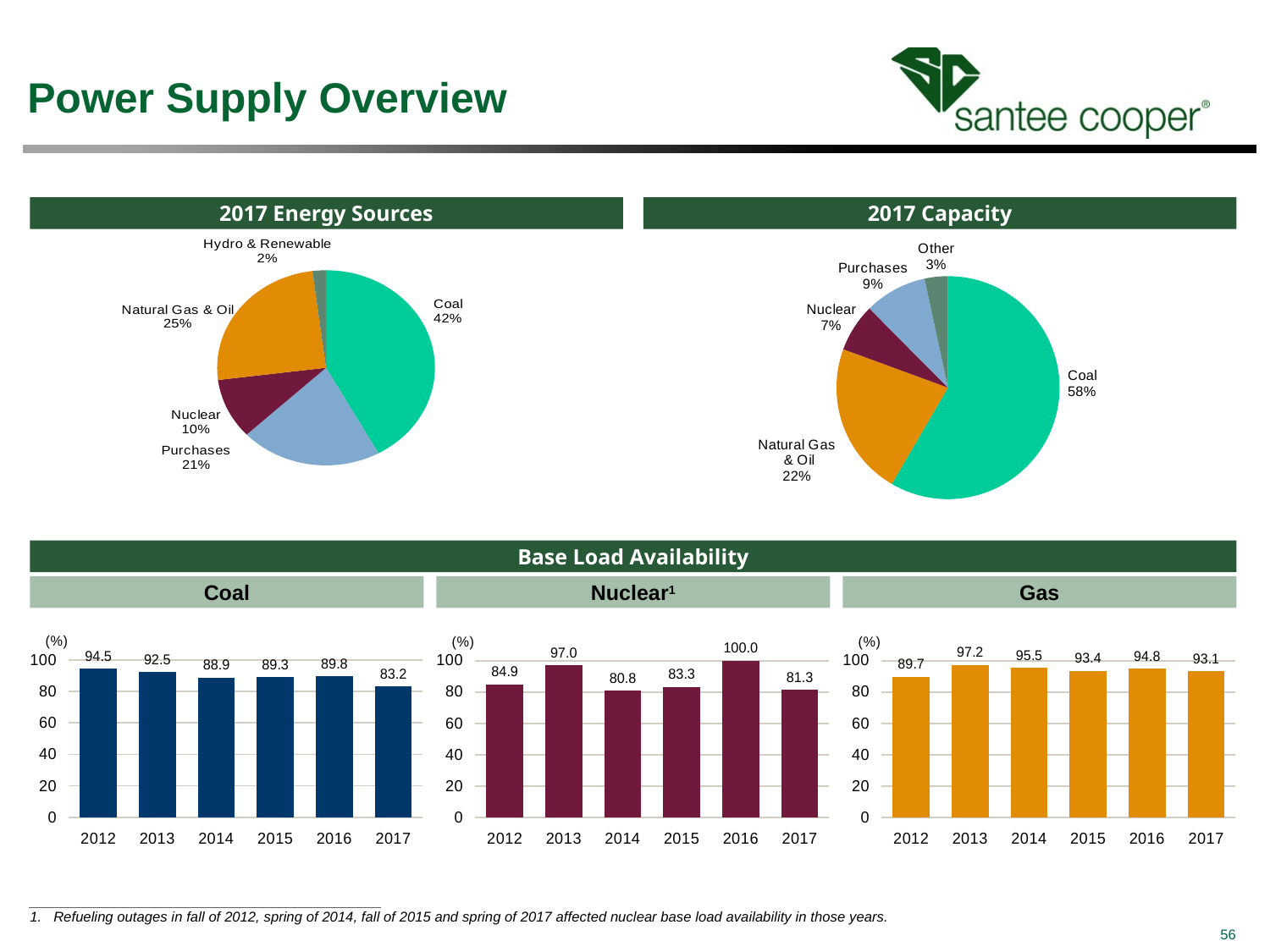
In the 2017 Energy Sources pie chart, what share does Coal have? 42% In the Gas base load availability chart, which is larger, the value for 2013 or the value for 2015? 2013 In the Coal base load availability chart, which year has the lowest value? 2017 In the 2017 Energy Sources pie chart, what share does Natural Gas & Oil have? 25% What kind of chart is the Gas base load availability chart? Bar chart In the 2017 Energy Sources pie chart, which source has the smallest share? Hydro & Renewable In the Nuclear base load availability chart, which year has the highest value? 2016 In the Nuclear base load availability chart, what is the difference between the 2013 and 2014 values? 16.2 In the 2017 Capacity pie chart, how many slices are there? 5 In the Coal base load availability chart, what is the value for 2012? 94.5 In the 2017 Capacity pie chart, what share does Purchases have? 9%